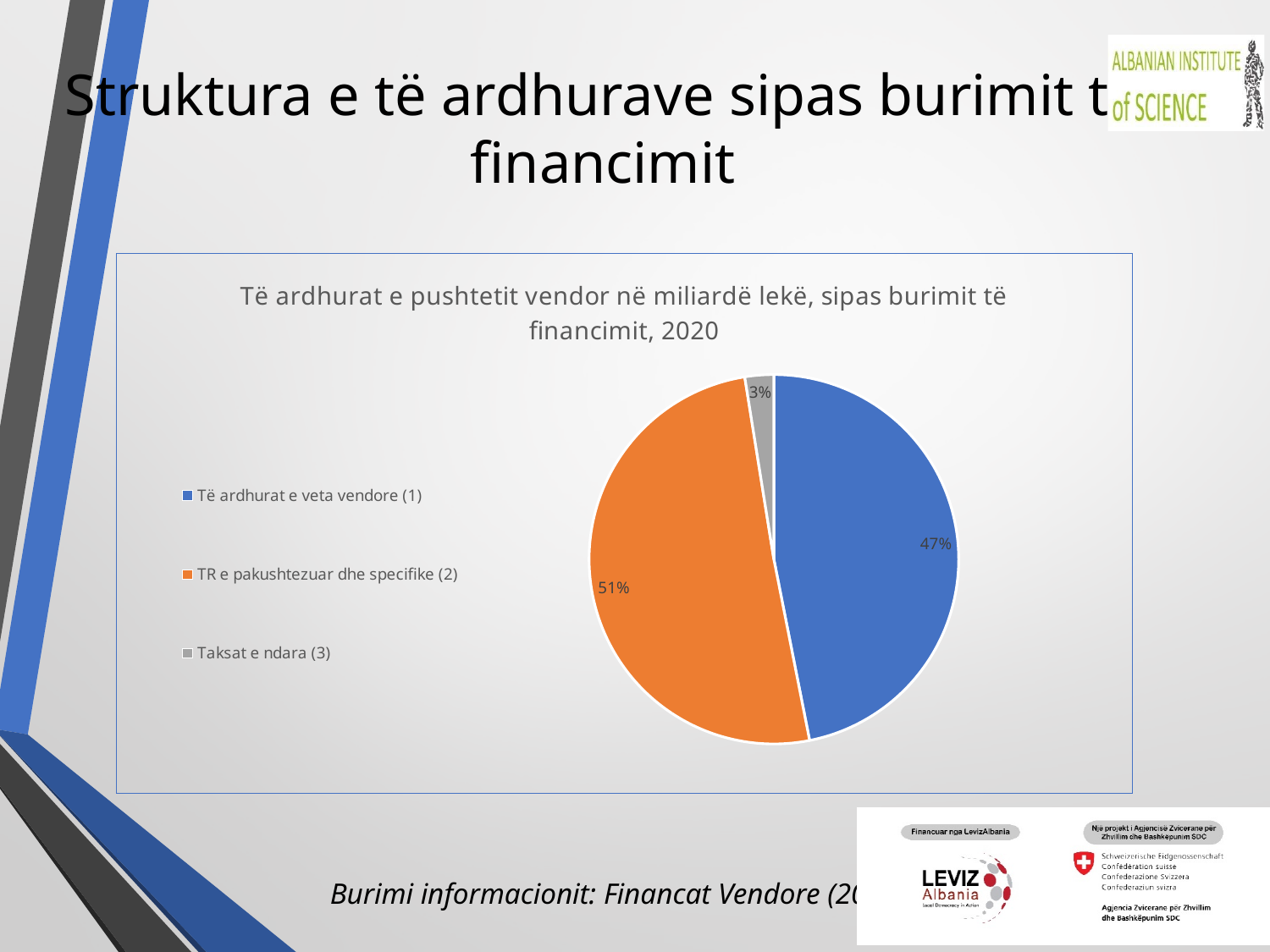
What is the title of the chart? Të ardhurat e pushtetit vendor në miliardë lekë, sipas burimit të financimit, 2020 What colour is the slice for "TR e pakushtezuar dhe specifike (2)"? orange Which category has the smallest slice of the pie? Taksat e ndara (3) What kind of chart is shown on the slide? pie chart Which is larger: the share for "Të ardhurat e veta vendore (1)" or the share for "Taksat e ndara (3)"? Të ardhurat e veta vendore (1) What is the difference in percentage points between "TR e pakushtezuar dhe specifike (2)" and "Të ardhurat e veta vendore (1)"? 4 percentage points Which category has the largest slice of the pie? TR e pakushtezuar dhe specifike (2) How many categories does the pie chart show? 3 What share of the pie does "Të ardhurat e veta vendore (1)" represent? 47% What share of the pie does "Taksat e ndara (3)" represent? 3% What share of the pie does "TR e pakushtezuar dhe specifike (2)" represent? 51% What is the difference in percentage points between "Të ardhurat e veta vendore (1)" and "Taksat e ndara (3)"? 44 percentage points